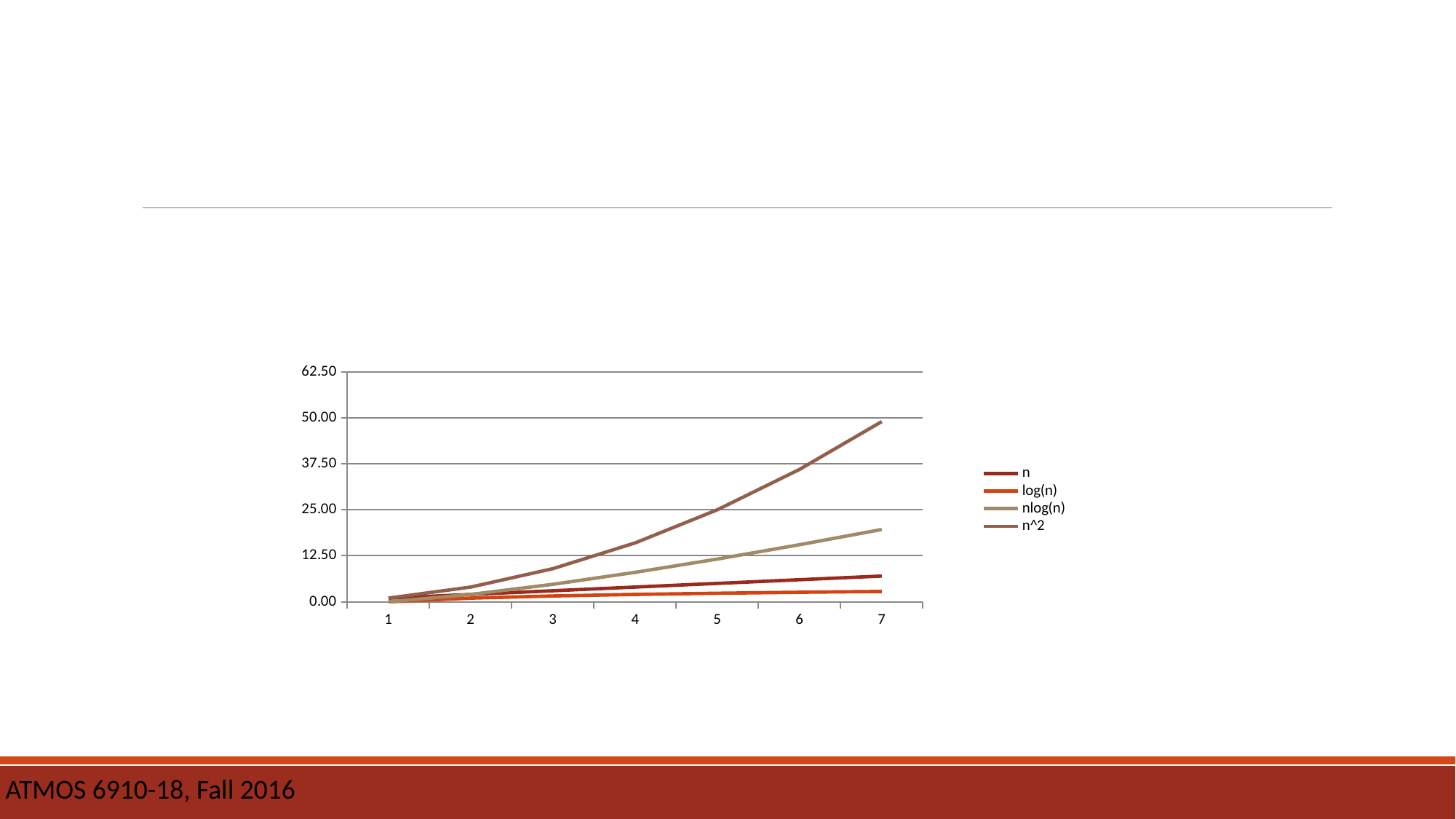
How many series does the legend list? 4 At x = 7, which is larger, n^2 or nlog(n)? n^2 Is the value of n^2 at x = 7 greater or less than 37.50? greater Which series has the highest value at x = 7? n^2 What kind of chart is shown on the slide? line chart Is the value of nlog(n) at x = 7 greater or less than 25.00? less Which series has the lowest value at x = 7? log(n) Is the value of n at x = 7 greater or less than 12.50? less What are the legend entries of the chart, in order? n, log(n), nlog(n), n^2 How many points are plotted along the x axis for each series? 7 Does the n^2 series rise or fall as x increases from 1 to 7? rise At x = 7, which is larger, n or log(n)? n